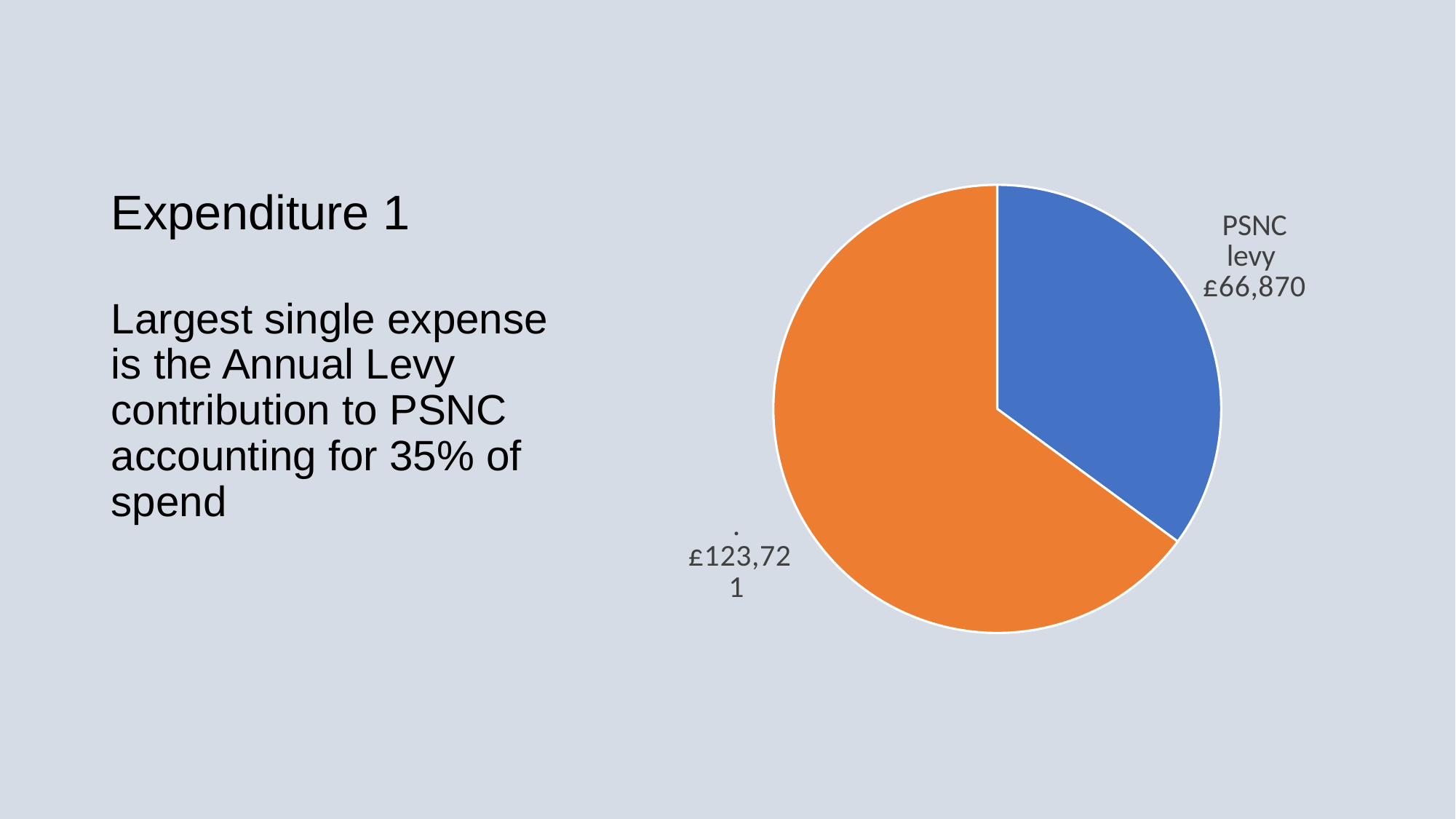
How many slices does the pie chart have? 2 What share of the pie does the PSNC levy slice represent? 35% What is the value shown for the orange slice of the pie chart? £123,721 Which slice of the pie chart is the smallest? PSNC levy (£66,870) What is the difference between the orange slice (£123,721) and the PSNC levy slice (£66,870)? £56,851 What kind of chart is shown on the slide? pie chart What is the total of the two slices in the pie chart? £190,591 Which is larger, the PSNC levy slice or the orange slice? the orange slice Which slice of the pie chart is the largest? the orange slice (£123,721) What colour is the PSNC levy slice? blue What is the value of the PSNC levy slice? £66,870 What is the heading of the slide containing the pie chart? Expenditure 1